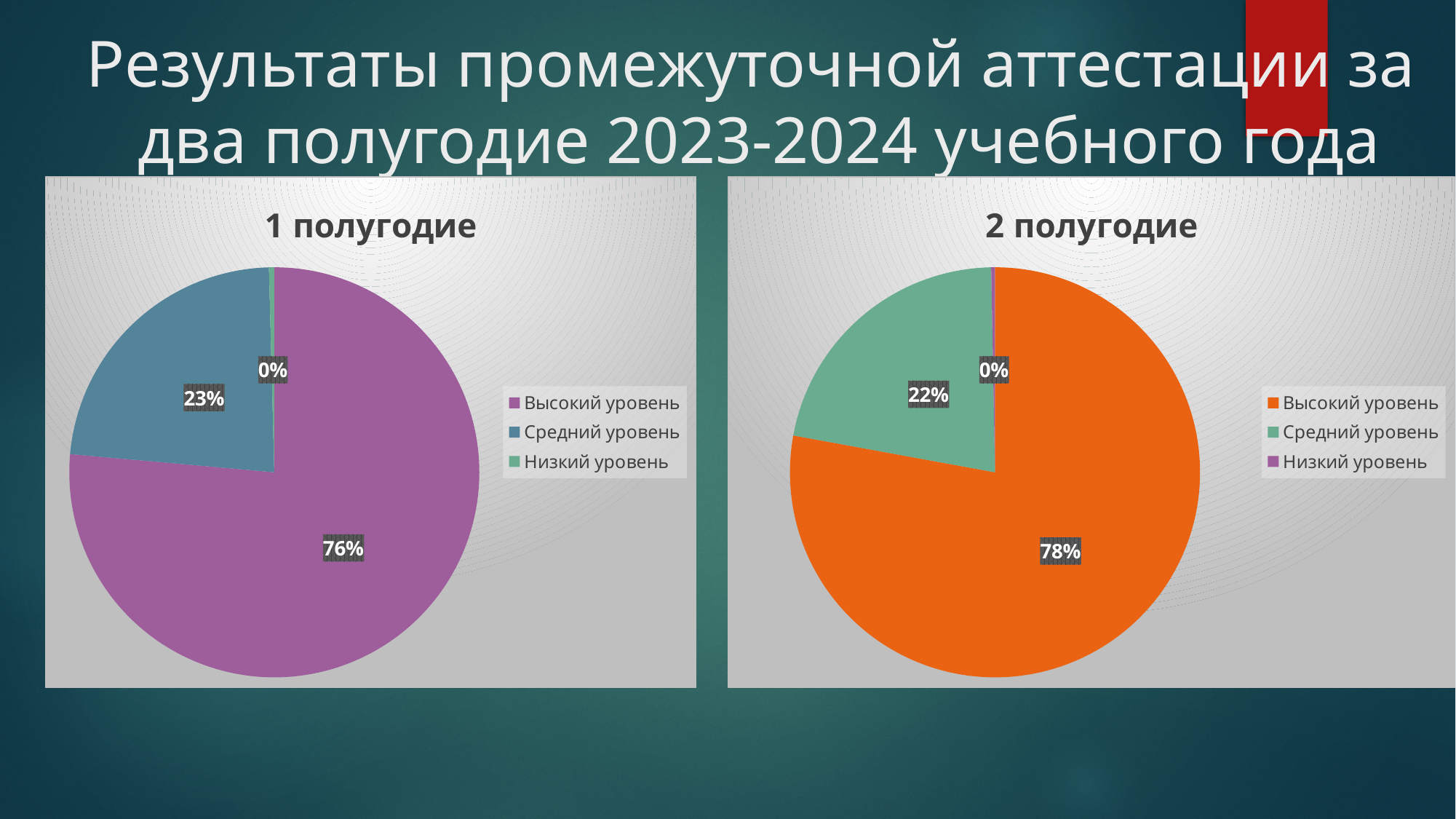
What is the difference between the "Высокий уровень" share in the "2 полугодие" chart and in the "1 полугодие" chart? 2% How many categories does the legend of the "2 полугодие" chart list? 3 In the "1 полугодие" chart, what share does "Низкий уровень" have? 0% In the "1 полугодие" chart, what share does "Средний уровень" have? 23% In the "1 полугодие" chart, what share does "Высокий уровень" have? 76% In the "2 полугодие" chart, what colour is the "Высокий уровень" slice? Orange What type of chart is the "1 полугодие" chart? Pie chart In the "1 полугодие" chart, which category has the smallest slice? Низкий уровень Which chart has the larger share for "Средний уровень", "1 полугодие" or "2 полугодие"? 1 полугодие In the "2 полугодие" chart, which category has the largest slice? Высокий уровень